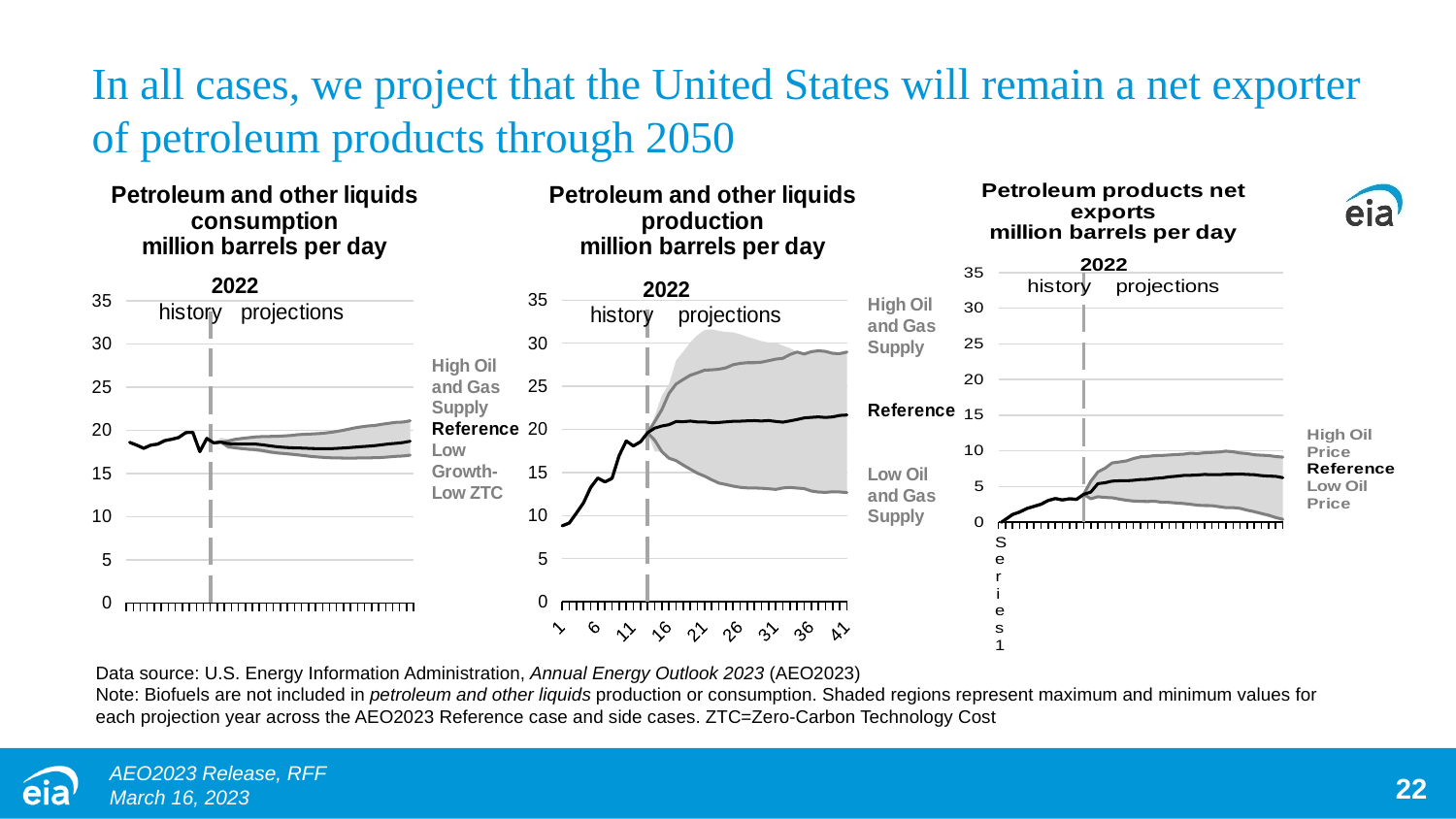
In the 'Petroleum and other liquids production' chart, is the value at the start of the history period greater or less than 15? less In the 'Petroleum products net exports' chart, is the Low Oil Price value at the end of the projection period greater or less than 5? less In the 'Petroleum and other liquids production' chart, is the peak of the High Oil and Gas Supply shaded region greater or less than 30? greater In the 'Petroleum and other liquids production' chart, do values rise or fall over the history period? rise What year does the dashed vertical line separating history from projections mark in each chart? 2022 What kind of chart is the 'Petroleum and other liquids consumption' chart? combination area and line chart (a line with a shaded area band) How many charts are shown on the slide? 3 What unit is used on the y axis of all three charts? million barrels per day